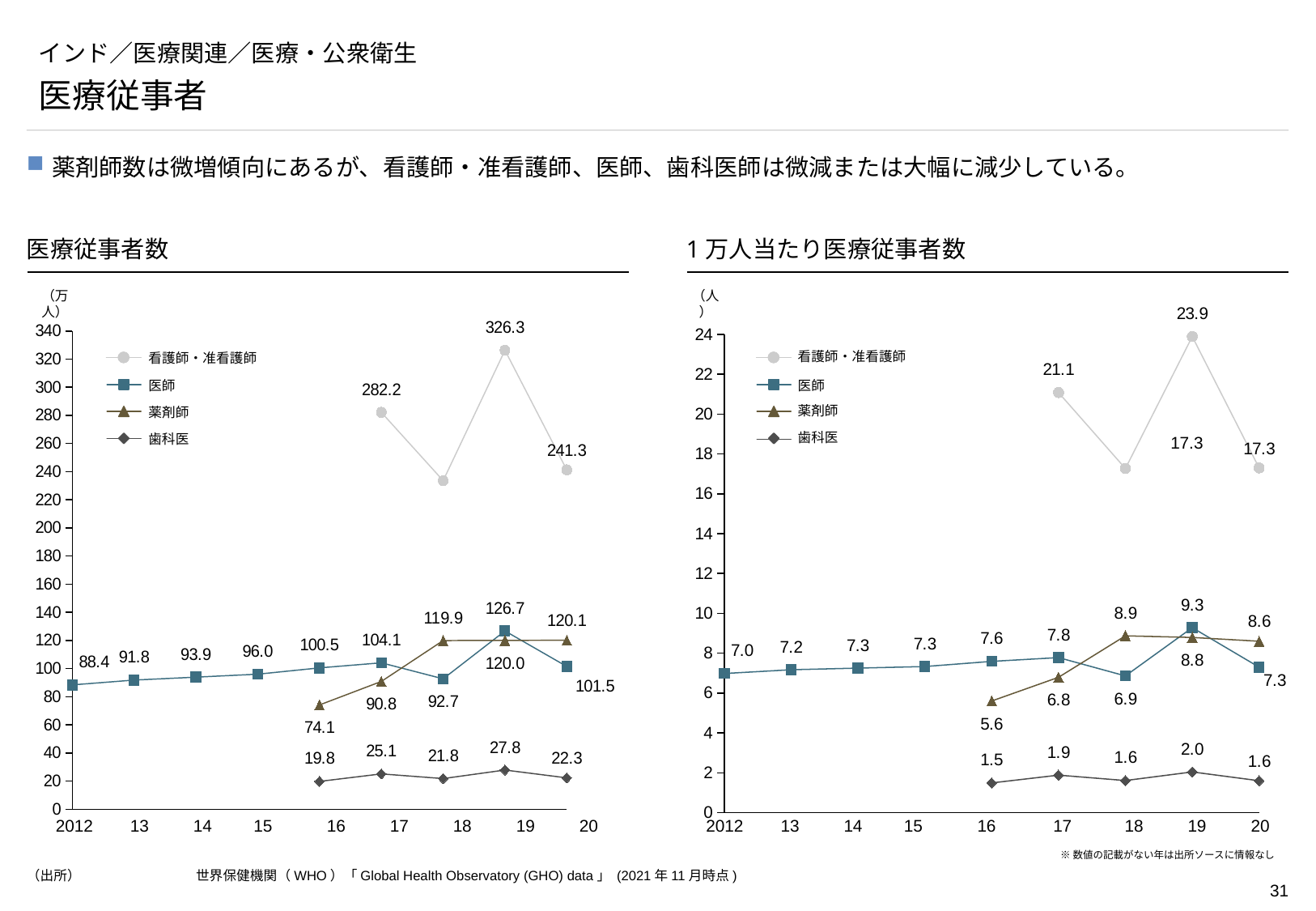
What kind of chart is the right chart (1万人当たり医療従事者数)? line chart In the left chart (医療従事者数), what is the value for 看護師・准看護師 in 2019? 326.3 In the left chart (医療従事者数), is the 看護師・准看護師 value in 2018 greater or less than 260? less In the left chart (医療従事者数), what is the value for 医師 in 2012? 88.4 In the right chart (1万人当たり医療従事者数), which is larger in 2018: 薬剤師 or 医師? 薬剤師 In the left chart (医療従事者数), in which year is the 歯科医 value highest? 2019 In the right chart (1万人当たり医療従事者数), in which year is the 薬剤師 value lowest? 2016 In the right chart (1万人当たり医療従事者数), what is the value for 医師 in 2019? 9.3 In the right chart (1万人当たり医療従事者数), how many data points are plotted for 歯科医? 5 In the left chart (医療従事者数), what is the value for 薬剤師 in 2016? 74.1 In the left chart (医療従事者数), what is the difference between the 看護師・准看護師 values in 2019 and 2020? 85.0 In the left chart (医療従事者数), how many series does the legend list? 4